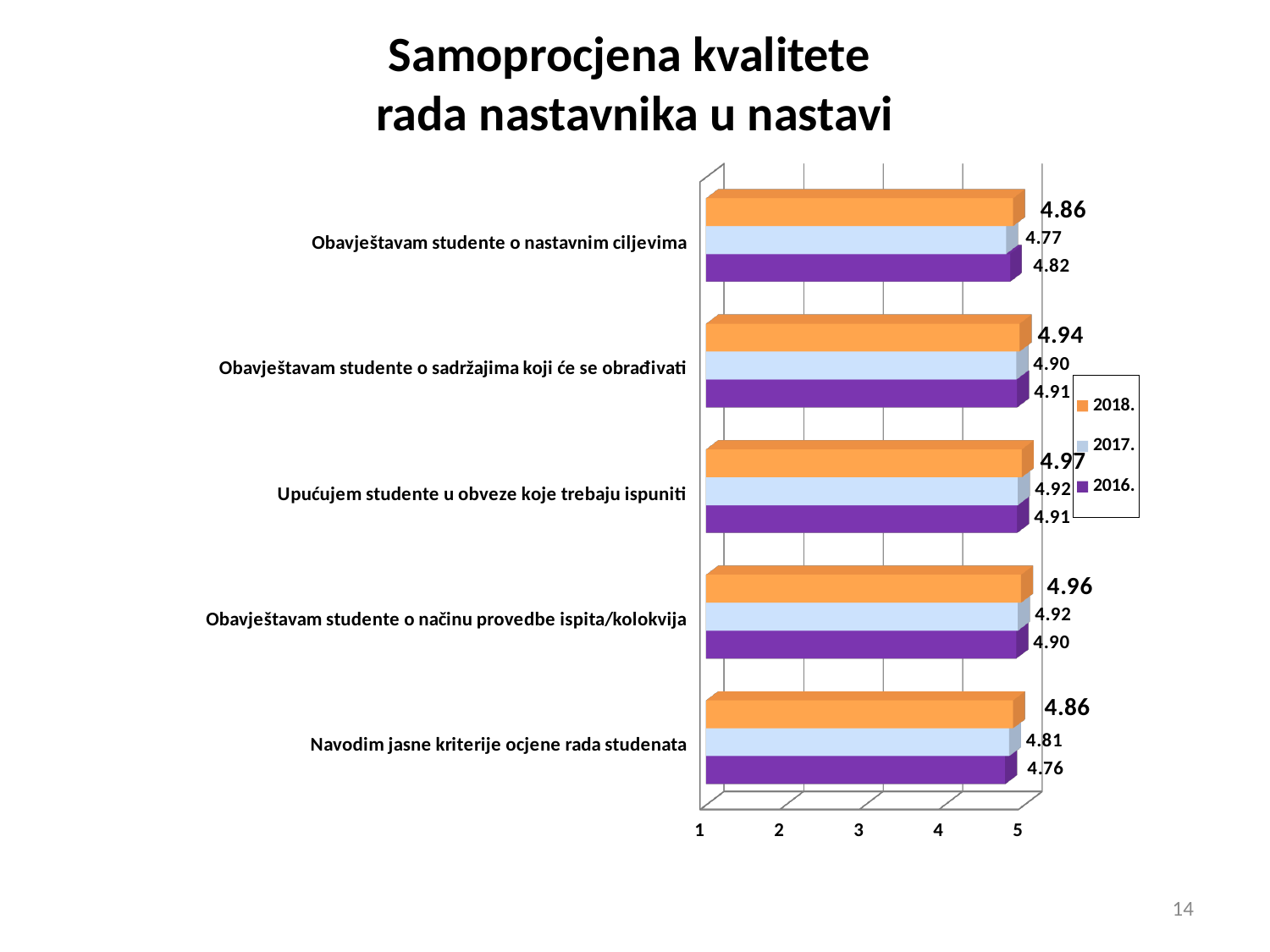
What is the 2016. value for "Navodim jasne kriterije ocjene rada studenata"? 4.76 For "Obavještavam studente o nastavnim ciljevima", which is larger: the 2017. value or the 2016. value? 2016. How many series does the legend list? 3 What is the 2017. value for "Obavještavam studente o nastavnim ciljevima"? 4.77 Which category has the lowest 2017. value? Obavještavam studente o nastavnim ciljevima Which category has the highest 2018. value? Upućujem studente u obveze koje trebaju ispuniti What kind of chart is shown on the slide? Bar chart Which category has the lowest 2016. value? Navodim jasne kriterije ocjene rada studenata What is the 2018. value for "Obavještavam studente o načinu provedbe ispita/kolokvija"? 4.96 What is the 2018. value for "Upućujem studente u obveze koje trebaju ispuniti"? 4.97 How many categories are shown in the chart? 5 What is the difference between the 2018. and 2016. values for "Navodim jasne kriterije ocjene rada studenata"? 0.10